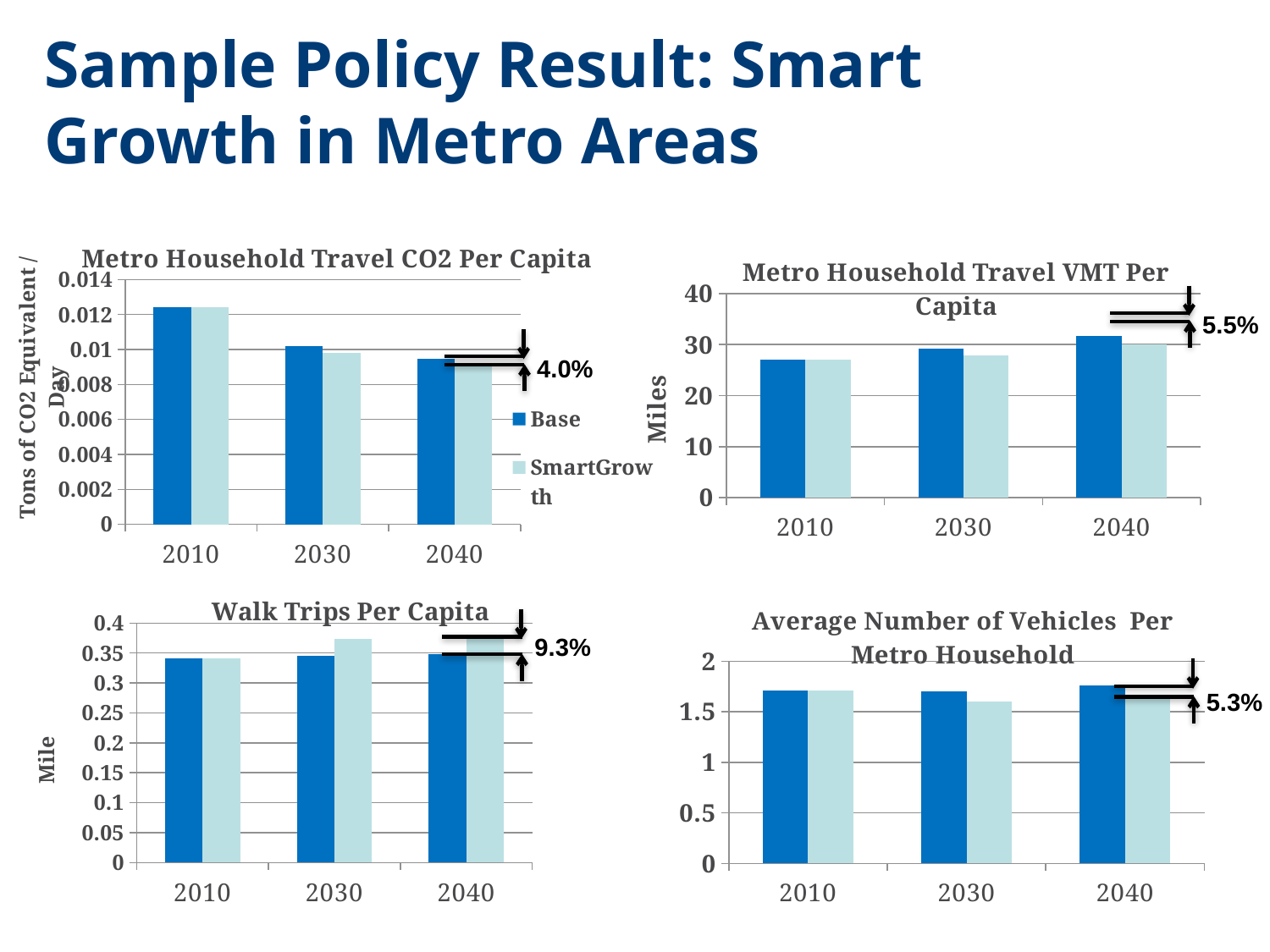
In the Metro Household Travel CO2 Per Capita chart, which year has the highest Base value? 2010 In the Walk Trips Per Capita chart, which is larger in 2040, the Base value or the SmartGrowth value? SmartGrowth In the Metro Household Travel CO2 Per Capita chart, how many series does the legend list? 2 What percentage annotation is shown on the Walk Trips Per Capita chart? 9.3% In the Metro Household Travel CO2 Per Capita chart, how many years are shown on the x axis? 3 In the Metro Household Travel CO2 Per Capita chart, is the Base value for 2040 greater or less than 0.01? less In the Metro Household Travel CO2 Per Capita chart, what kind of chart is shown? bar chart In the Metro Household Travel VMT Per Capita chart, is the Base value for 2040 greater or less than 30? greater In the Walk Trips Per Capita chart, is the SmartGrowth value for 2040 greater or less than 0.35? greater In the Metro Household Travel VMT Per Capita chart, do the Base values rise or fall from 2010 to 2040? rise In the Metro Household Travel CO2 Per Capita chart, do the Base values rise or fall from 2010 to 2040? fall